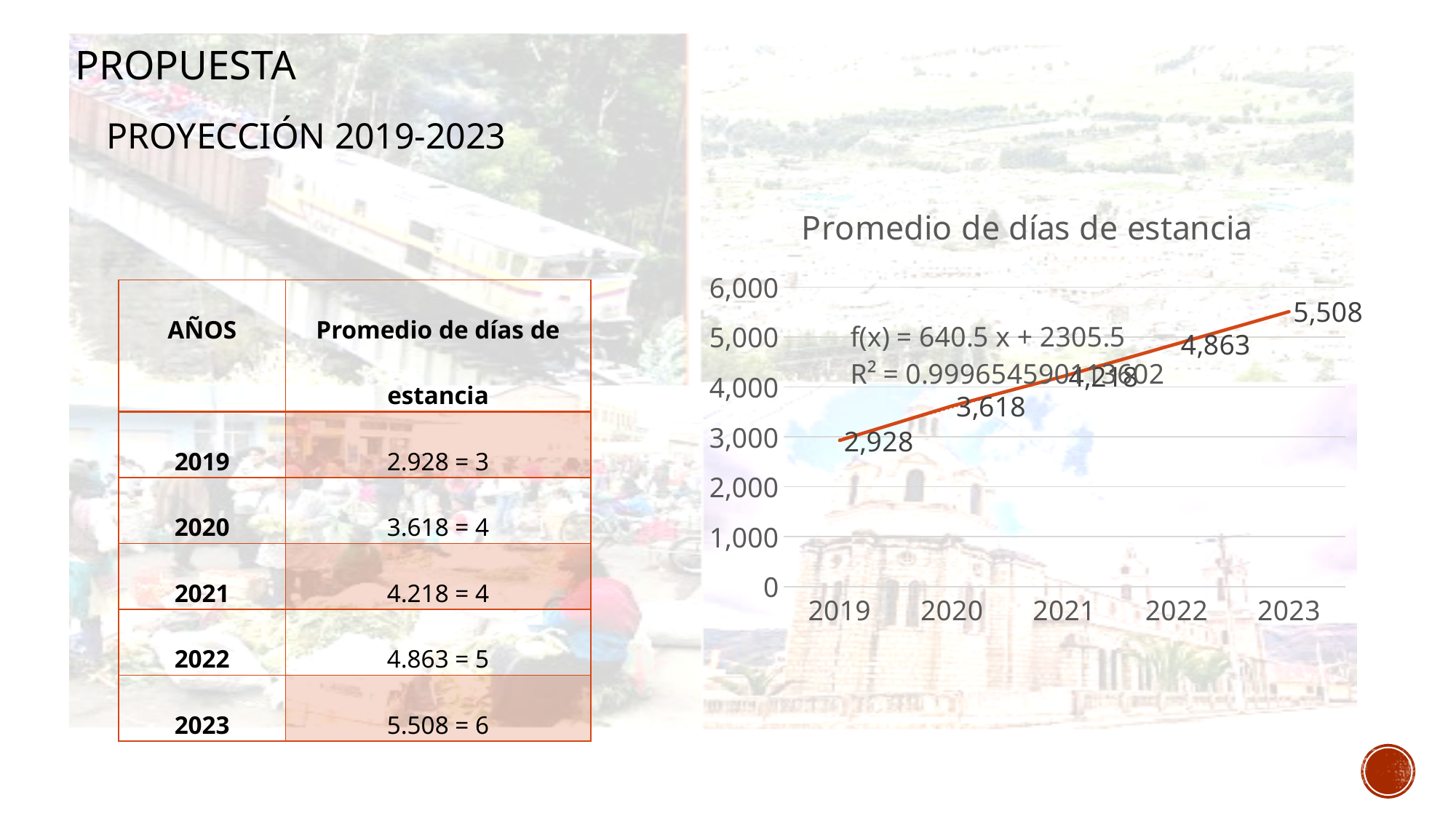
Do the values rise or fall from 2019 to 2023? rise Which year has the highest value in the chart? 2023 What kind of chart is shown on the slide? line chart What is the title of the chart? Promedio de días de estancia How many years are plotted on the x axis of the chart? 5 Which is larger, the value for 2020 or the value for 2022? 2022 Which year has the lowest value in the chart? 2019 What is the value for 2019 in the chart? 2,928 What is the difference between the values for 2023 and 2019? 2,580 What is the value for 2023 in the chart? 5,508 What is the value for 2020 in the chart? 3,618 What is the value for 2022 in the chart? 4,863